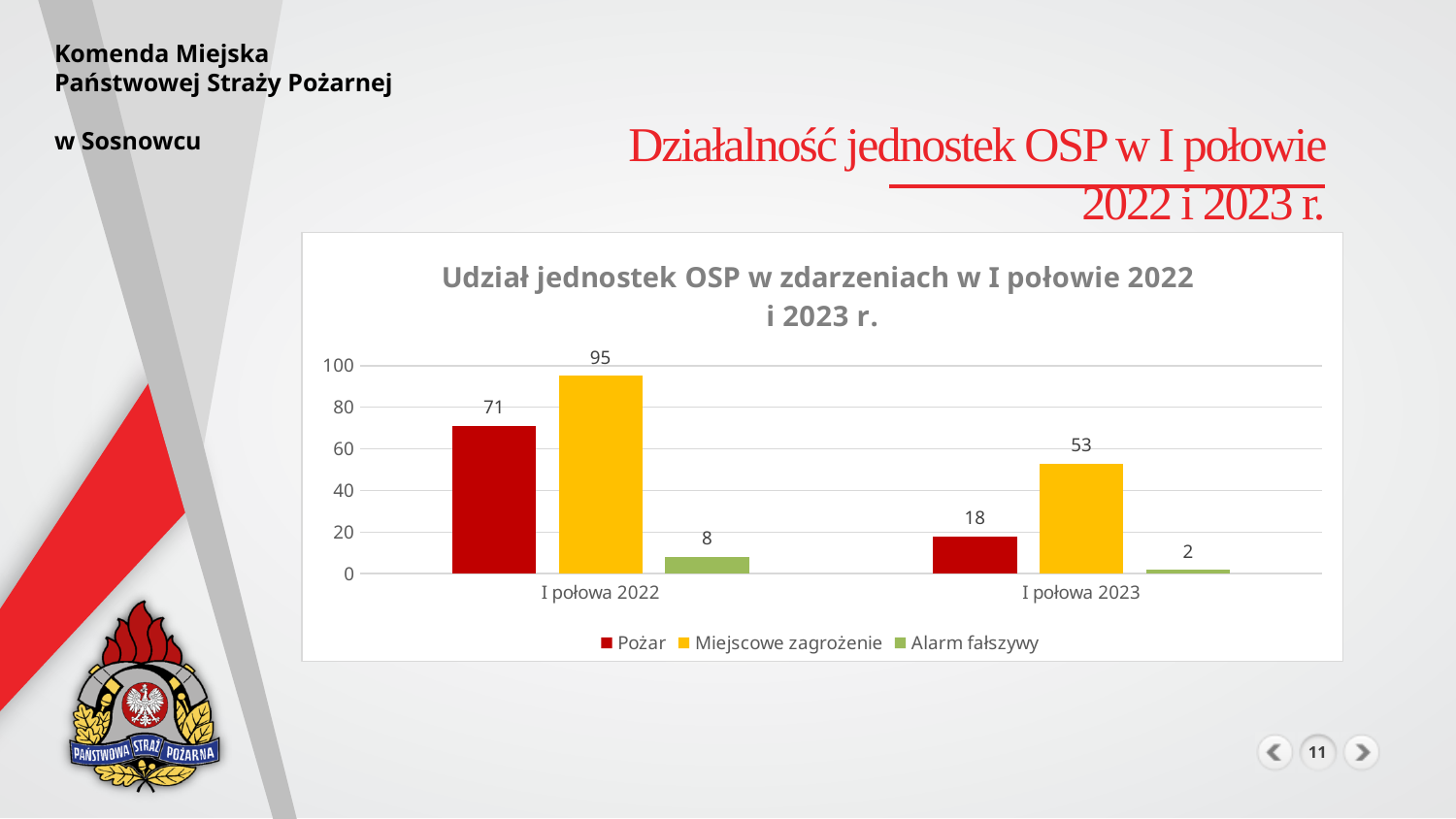
What is the difference between Miejscowe zagrożenie in I połowa 2022 and I połowa 2023? 42 Which series has the lowest value in I połowa 2023? Alarm fałszywy Which series has the highest value in I połowa 2022? Miejscowe zagrożenie What is the value for Miejscowe zagrożenie in I połowa 2023? 53 What is the value for Pożar in I połowa 2022? 71 How many series does the legend list? 3 What is the title of the chart? Udział jednostek OSP w zdarzeniach w I połowie 2022 i 2023 r. What is the difference between the Pożar values for I połowa 2022 and I połowa 2023? 53 Which is larger: Pożar in I połowa 2023 or Alarm fałszywy in I połowa 2022? Pożar in I połowa 2023 Is the value for Miejscowe zagrożenie in I połowa 2022 greater or less than 80? greater What kind of chart is shown on the slide? Bar chart What is the value for Alarm fałszywy in I połowa 2022? 8